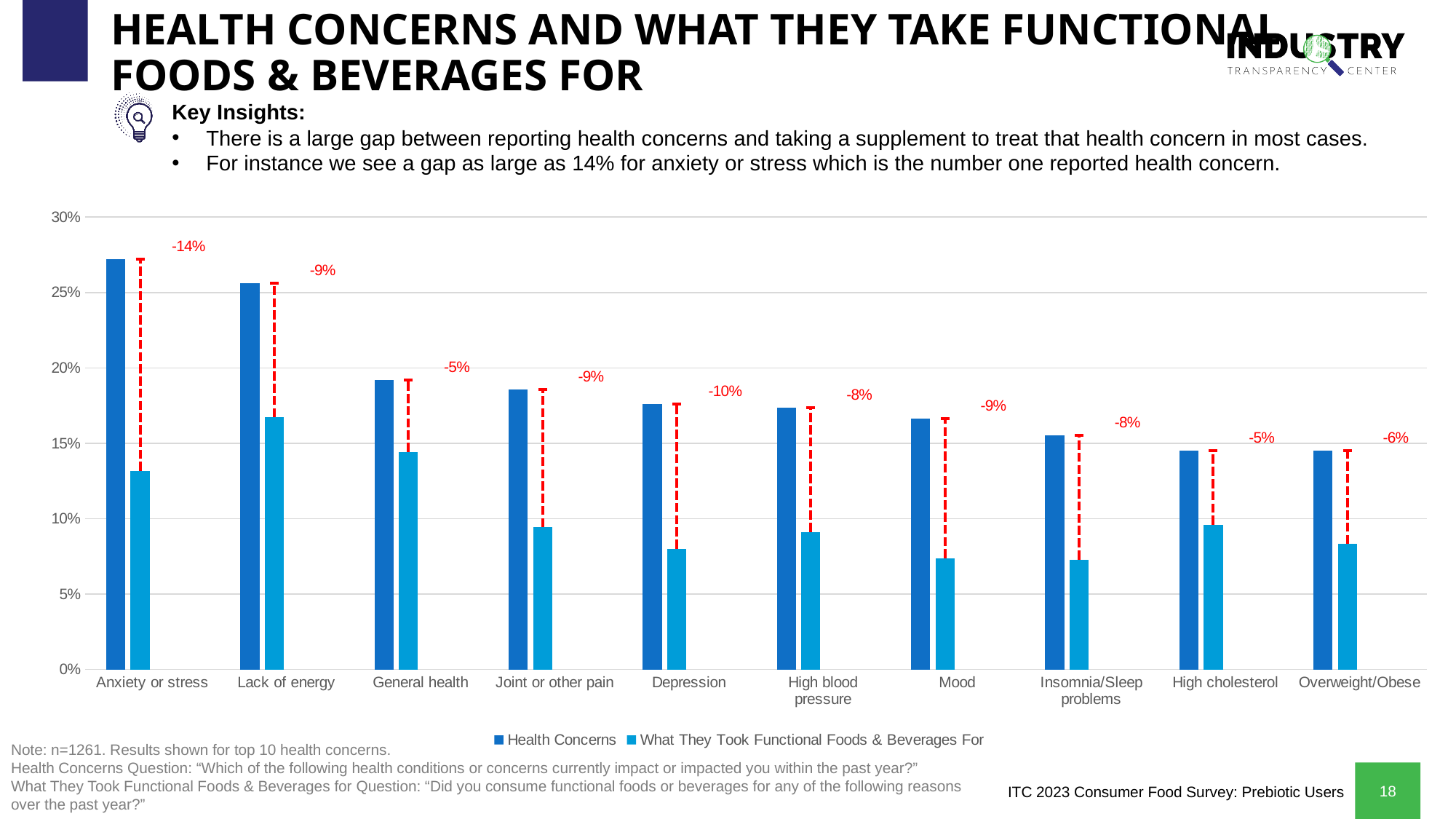
What kind of chart is shown on the slide? Bar chart How many health concern categories are shown on the x axis? 10 What gap is labelled above the Depression bars? -10% Is the Health Concerns value for Anxiety or stress greater or less than 25%? greater What gap is labelled above the General health bars? -5% Is the What They Took Functional Foods & Beverages For value for Mood greater or less than 10%? less Do the Health Concerns values rise or fall moving from left to right along the x axis? Fall Which has the larger Health Concerns value, Lack of energy or General health? Lack of energy Which category has the highest Health Concerns value? Anxiety or stress What gap is labelled above the Anxiety or stress bars? -14% How many series does the chart legend list? 2 Which category has the highest value for What They Took Functional Foods & Beverages For? Lack of energy